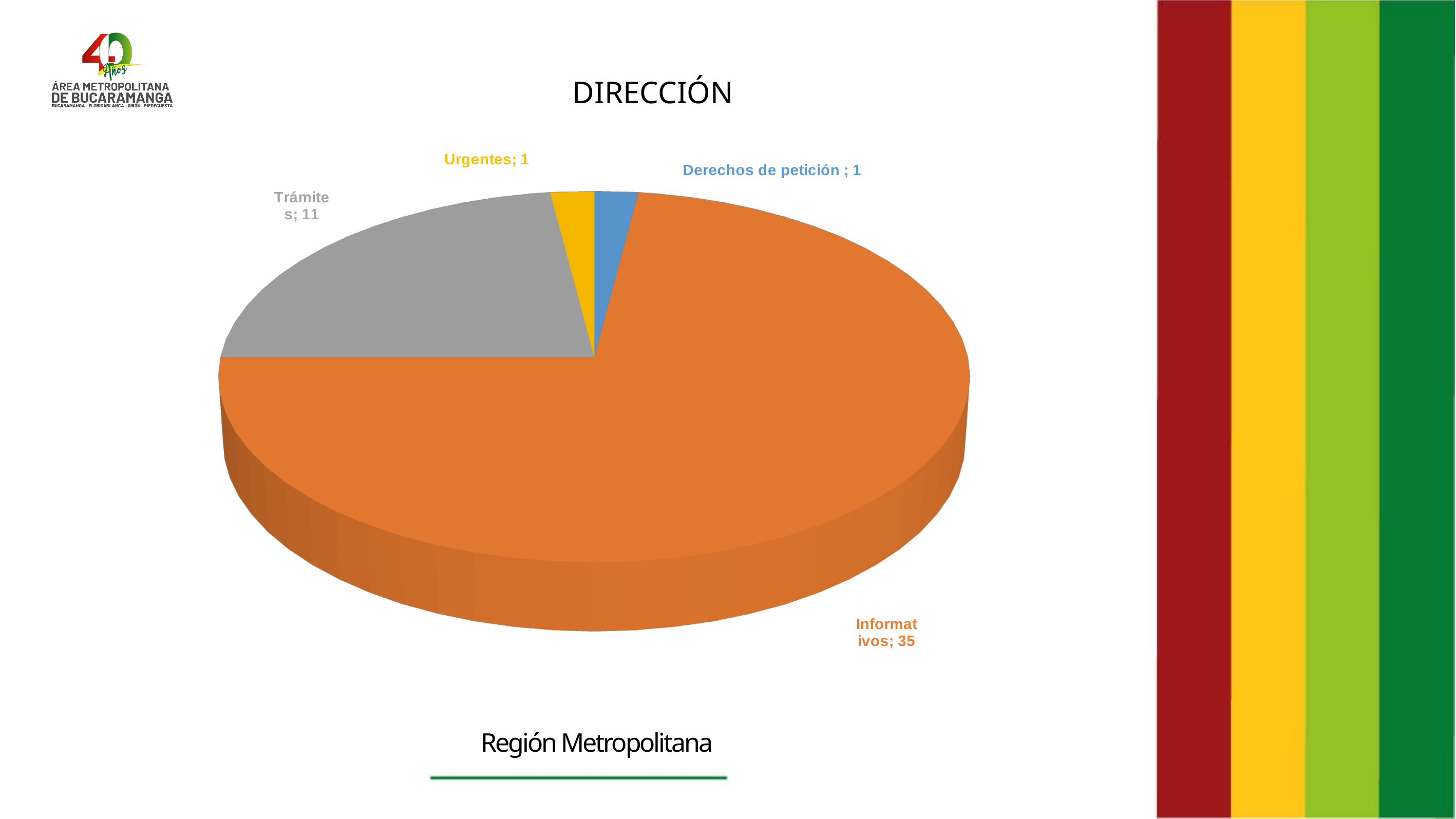
What kind of chart is shown on the slide? Pie chart What is the value for Trámites? 11 How many categories are shown in the pie chart? 4 Which category has the largest slice of the pie? Informativos What is the difference between the values for Informativos and Trámites? 24 Which is larger, the value for Trámites or the value for Urgentes? Trámites What is the value for Derechos de petición? 1 What is the total of all the slices in the pie chart? 48 What is the value for Informativos? 35 What is the title of the chart? DIRECCIÓN What is the value for Urgentes? 1 What is the difference between the values for Trámites and Urgentes? 10